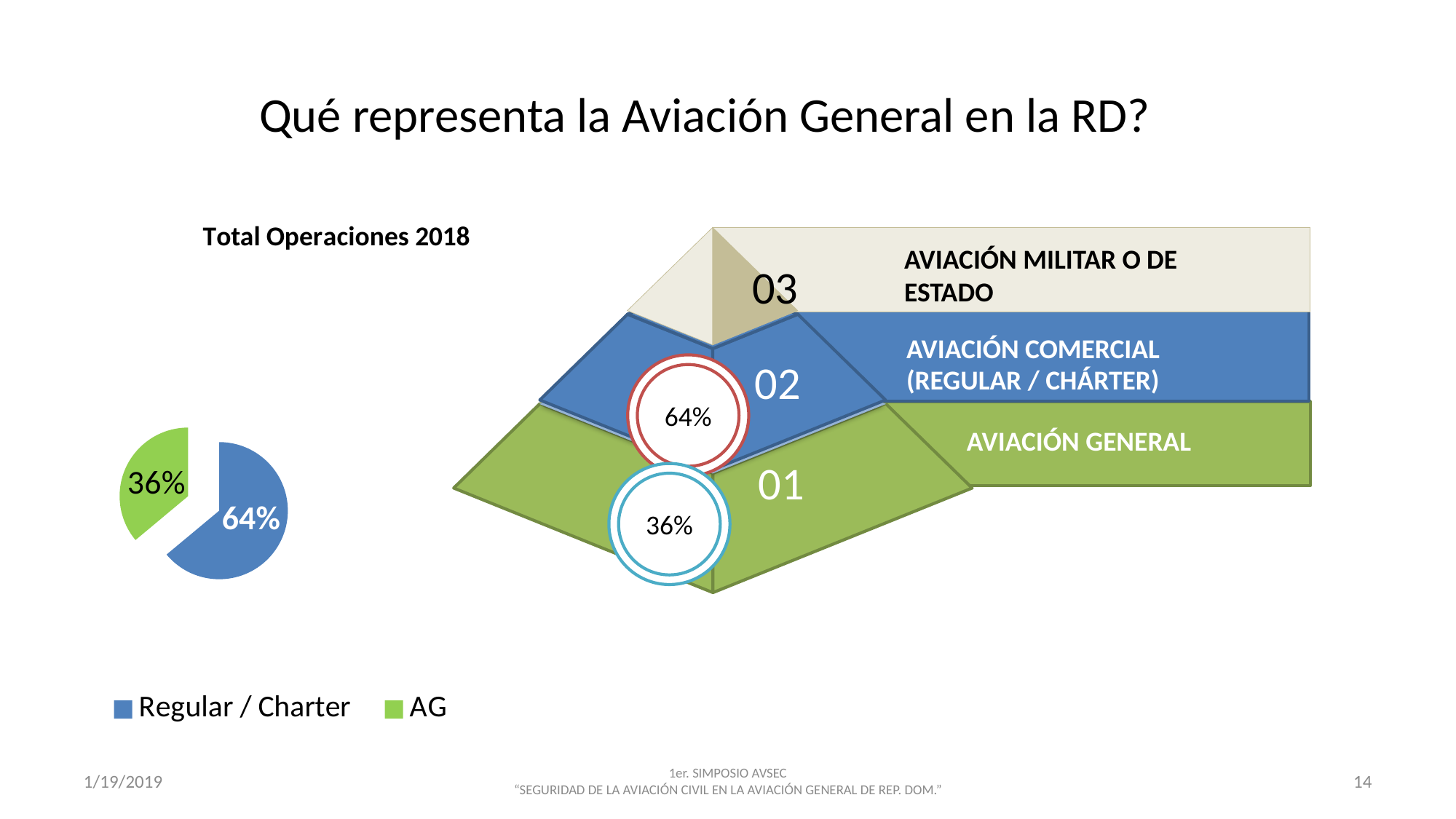
In the 'Total Operaciones 2018' chart, what colour is the AG slice? green How many entries does the legend of the 'Total Operaciones 2018' chart list? 2 In the 'Total Operaciones 2018' chart, which is larger, Regular / Charter or AG? Regular / Charter In the 'Total Operaciones 2018' chart, what share does Regular / Charter have? 64% What is the title of the pie chart on the slide? Total Operaciones 2018 In the 'Total Operaciones 2018' chart, what is the difference in percentage points between Regular / Charter and AG? 28 In the 'Total Operaciones 2018' chart, what share does AG have? 36% In the 'Total Operaciones 2018' chart, which category has the largest slice? Regular / Charter How many slices does the 'Total Operaciones 2018' pie chart have? 2 What kind of chart is 'Total Operaciones 2018'? pie chart In the 'Total Operaciones 2018' chart, which category has the smallest slice? AG